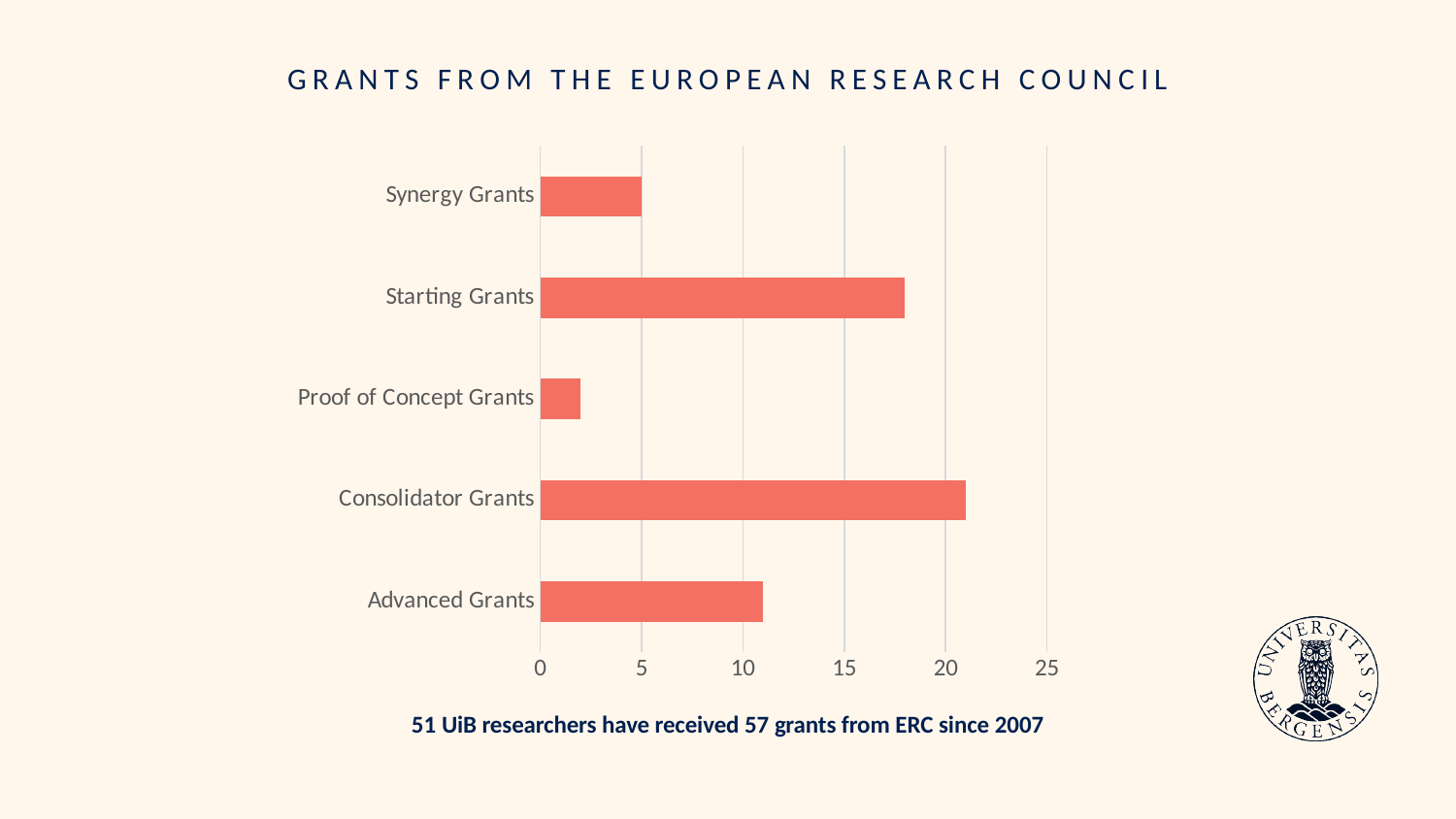
Which is larger, the value for Starting Grants or the value for Advanced Grants? Starting Grants What kind of chart is shown on the slide? bar chart What is the title of the chart? Grants from the European Research Council Which grant category has the highest number of grants? Consolidator Grants Is the value for Starting Grants greater or less than 15? greater Is the value for Advanced Grants greater or less than 10? greater Which grant category has the lowest number of grants? Proof of Concept Grants Which is larger, the value for Consolidator Grants or the value for Starting Grants? Consolidator Grants How many grant categories are shown in the chart? 5 Is the value for Consolidator Grants greater or less than 20? greater What is the value for Synergy Grants? 5